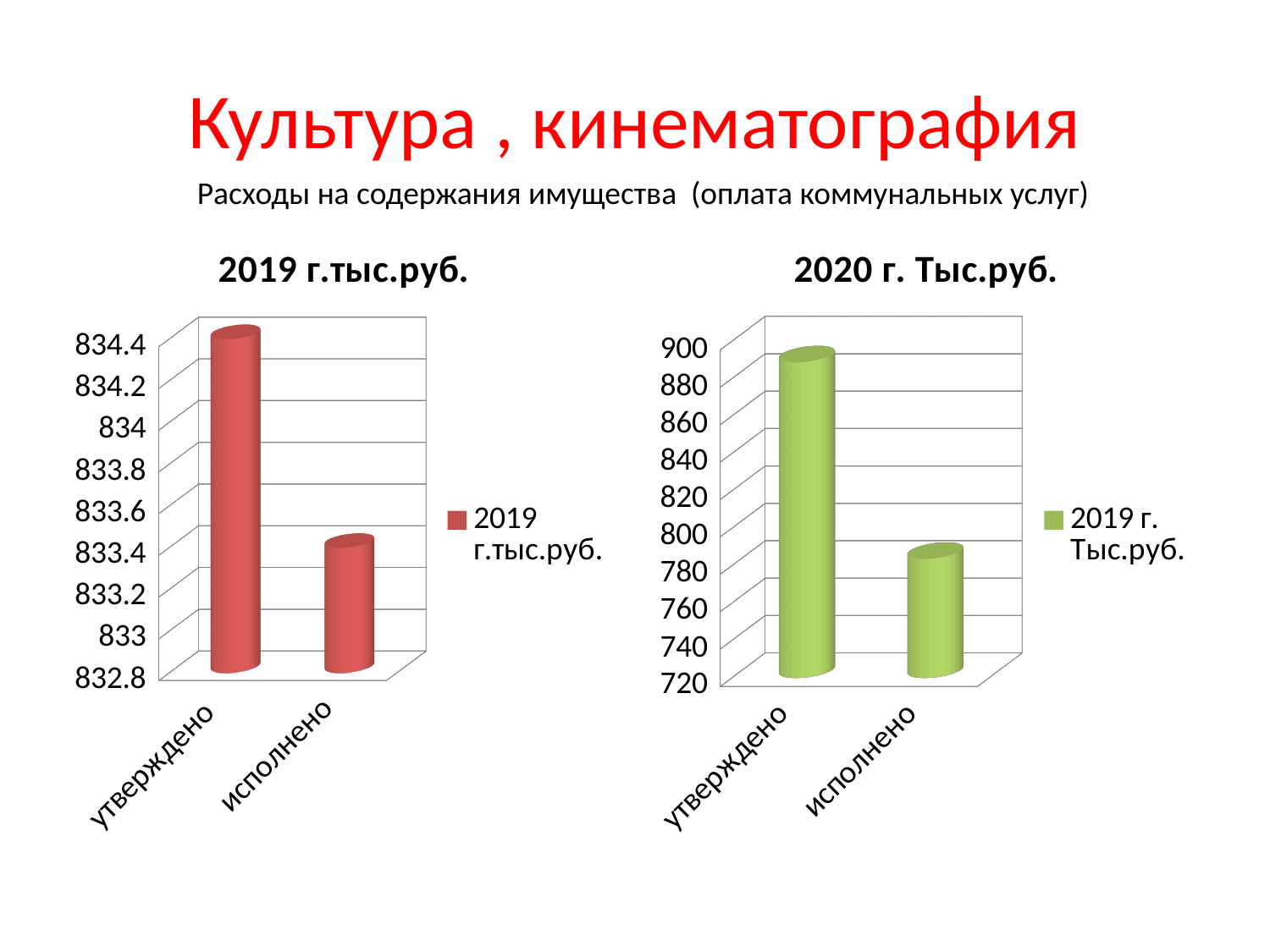
How many series does the legend of the chart titled "2020 г. Тыс.руб." list? 1 In the chart titled "2019 г.тыс.руб.", which category has the highest value? утверждено What kind of chart is the chart titled "2020 г. Тыс.руб."? bar chart In the chart titled "2020 г. Тыс.руб.", is the value for исполнено greater or less than 820? less In the chart titled "2020 г. Тыс.руб.", which category has the highest value? утверждено In the chart titled "2019 г.тыс.руб.", is the value for утверждено greater or less than 834? greater What colour are the bars in the chart titled "2020 г. Тыс.руб."? green In the chart titled "2019 г.тыс.руб.", which category has the lowest value? исполнено How many categories are shown in the chart titled "2019 г.тыс.руб."? 2 In the chart titled "2020 г. Тыс.руб.", is the value for утверждено greater or less than 860? greater In the chart titled "2020 г. Тыс.руб.", which is larger, утверждено or исполнено? утверждено